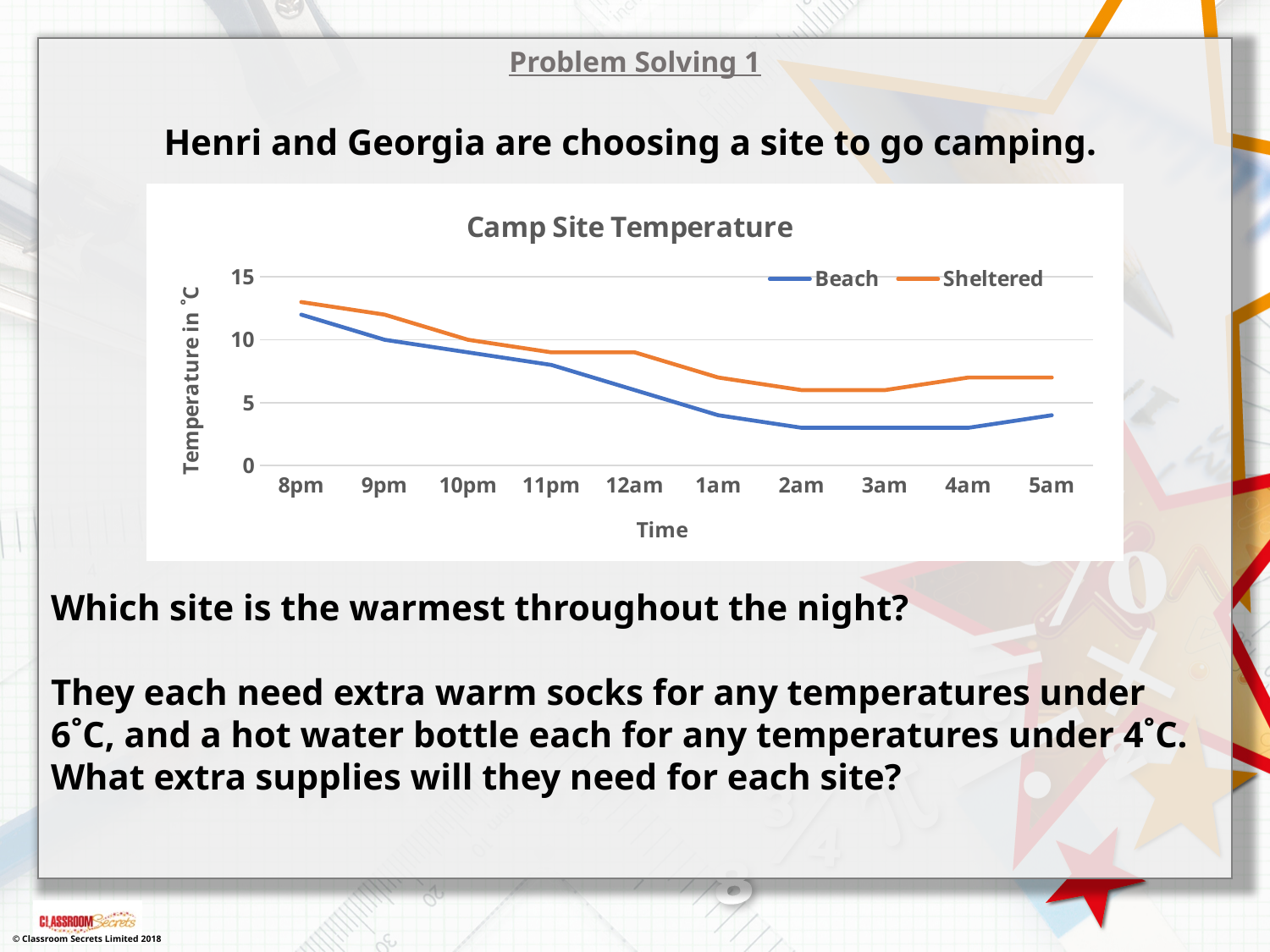
At 8pm, which site has the higher temperature, Beach or Sheltered? Sheltered What is the title of the chart? Camp Site Temperature At which time is the Beach temperature highest? 8pm Is the Sheltered temperature at 8pm greater or less than 10? greater What is the label on the vertical axis of the chart? Temperature in °C Does the Beach temperature rise or fall from 8pm to 2am? Fall At which time is the Sheltered temperature highest? 8pm How many series does the legend of the chart list? 2 Is the Beach temperature at 11pm greater or less than 5? greater What kind of chart is shown on the slide? Line chart Is the Beach temperature at 2am greater or less than 5? less How many time points are plotted along the x axis of the chart? 10